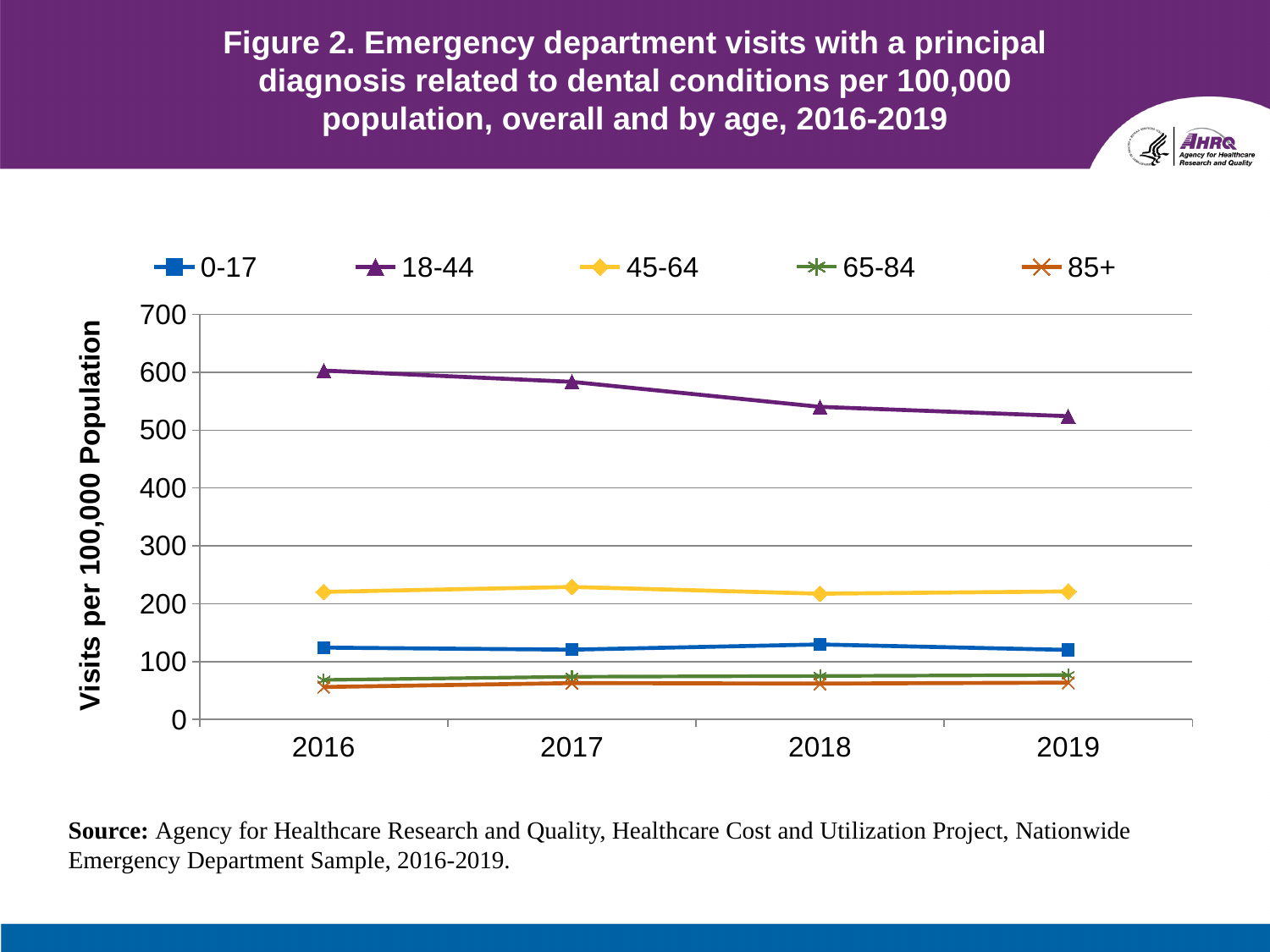
In which year is the value for the 18-44 age group lowest? 2019 In which year is the value for the 18-44 age group highest? 2016 How many years are plotted along the x axis? 4 Which is larger in 2016, the value for the 45-64 age group or the value for the 0-17 age group? 45-64 Is the value for the 18-44 age group in 2016 greater or less than 500? greater How many series does the legend list? 5 What is the title of the vertical axis? Visits per 100,000 Population Does the value for the 18-44 age group rise or fall from 2016 to 2019? fall What kind of chart is shown on the slide? line chart Is the value for the 45-64 age group in 2017 greater or less than 200? greater Which age group has the highest rate of emergency department visits in every year shown? 18-44 Is the value for the 18-44 age group in 2019 greater or less than 600? less